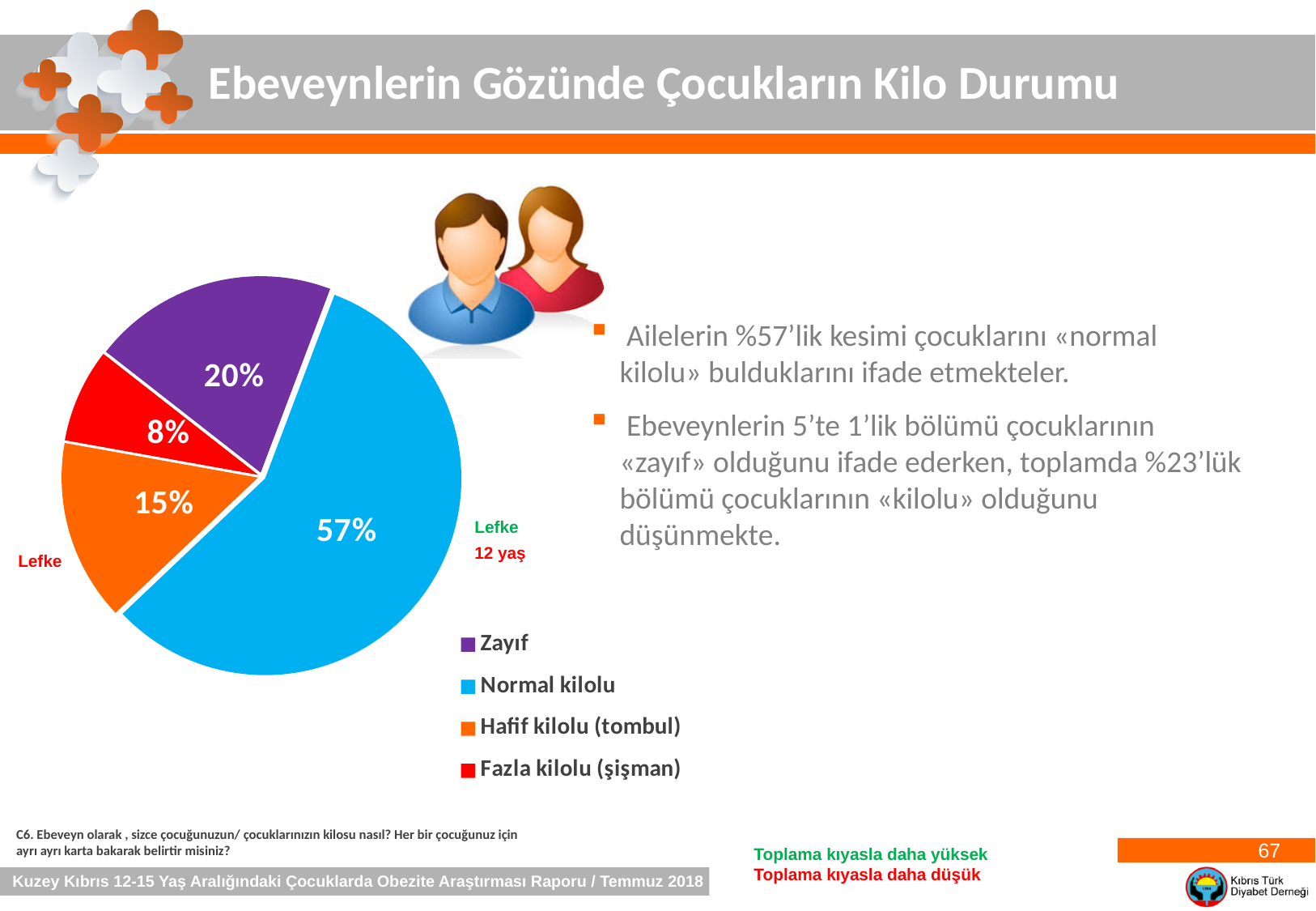
Which category has the smallest slice of the pie chart? Fazla kilolu (şişman) What percentage of the pie chart is labelled "Fazla kilolu (şişman)"? 8% How many slices does the pie chart have? 4 What percentage of the pie chart is labelled "Hafif kilolu (tombul)"? 15% What type of chart is shown on the slide? Pie chart What colour is the "Zayıf" slice in the pie chart? Purple What is the difference in percentage points between the "Normal kilolu" slice and the "Zayıf" slice? 37 What percentage of the pie chart is labelled "Zayıf"? 20% Which slice is larger, "Hafif kilolu (tombul)" or "Fazla kilolu (şişman)"? Hafif kilolu (tombul) How many entries does the chart legend list? 4 Which category has the largest slice of the pie chart? Normal kilolu What percentage of the pie chart is labelled "Normal kilolu"? 57%